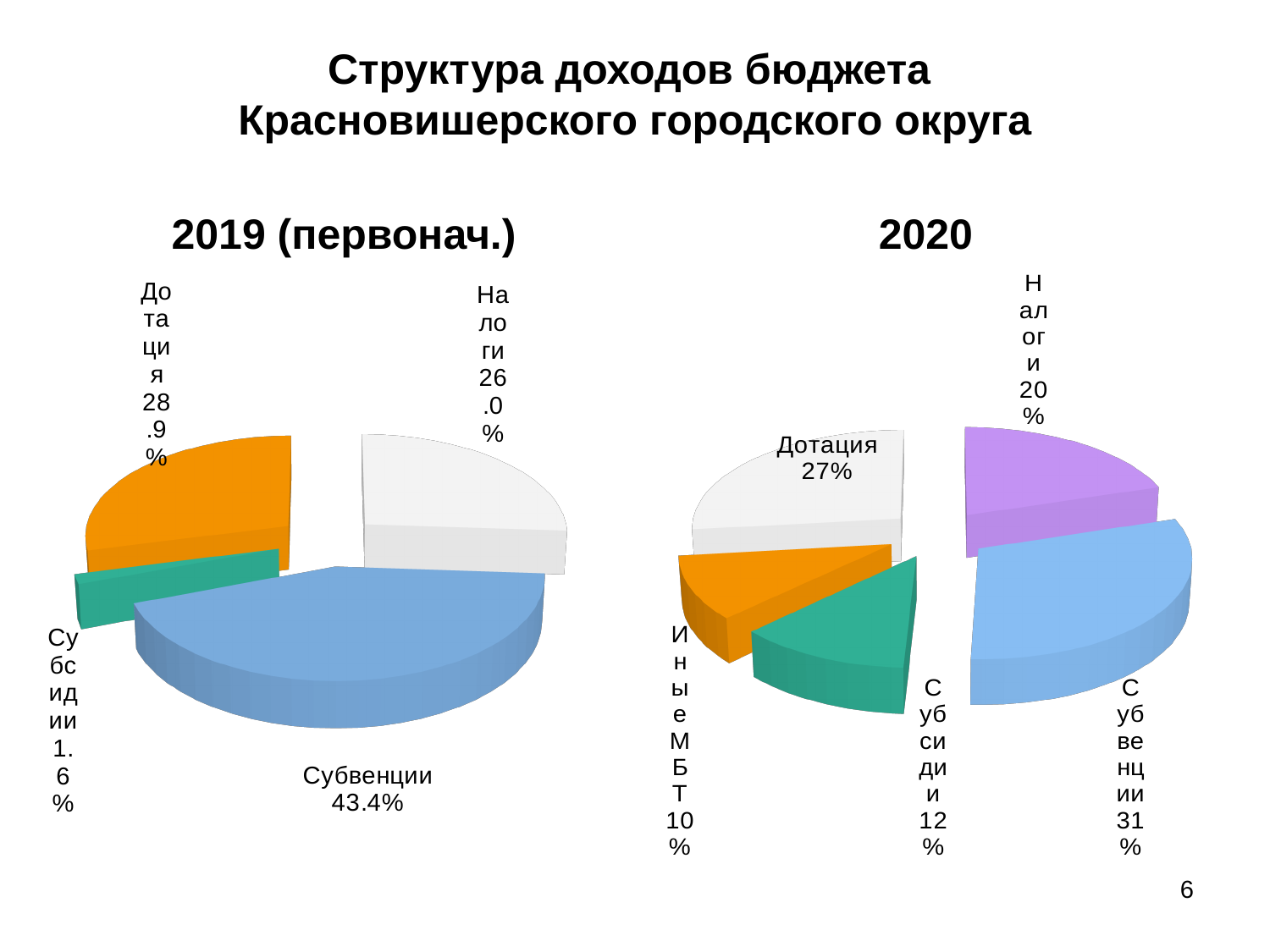
In the 2020 chart, what is the difference between the shares of Субвенции and Субсидии? 19% In the 2020 chart, what share do Иные МБТ have? 10% In the 2020 chart, how many slices does the pie have? 5 In the 2019 (первонач.) chart, how many slices does the pie have? 4 In the 2020 chart, what share do Субвенции have? 31% In the 2019 (первонач.) chart, what share does Дотация have? 28.9% In the 2019 (первонач.) chart, which category has the largest share? Субвенции What type of chart is used for the 2020 data? Pie chart In the 2019 (первонач.) chart, what share do Субвенции have? 43.4% In the 2019 (первонач.) chart, which category has the smallest share? Субсидии In the 2019 (первонач.) chart, what is the difference between the shares of Дотация and Налоги? 2.9% In the 2020 chart, which is larger, Налоги or Дотация? Дотация